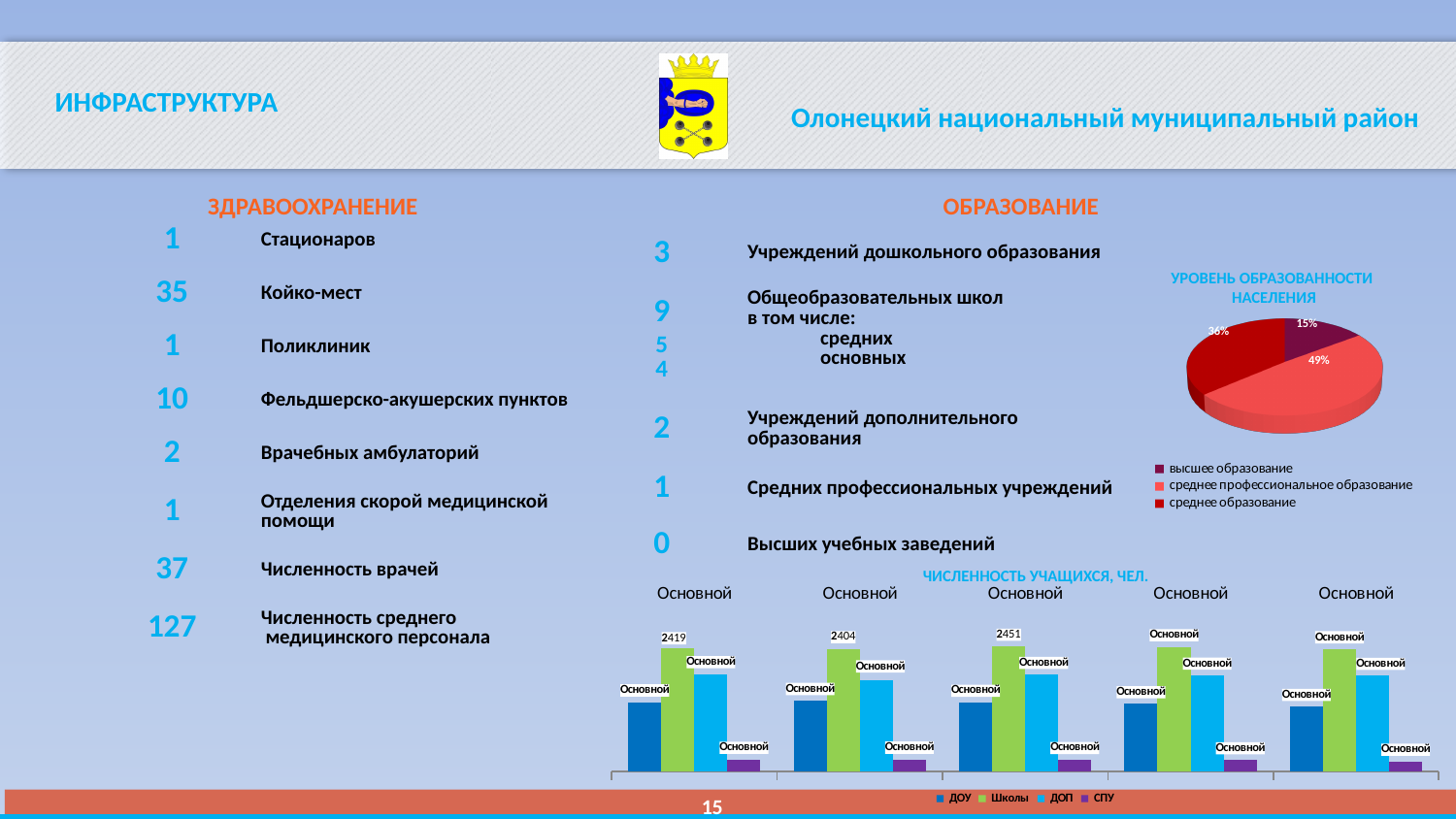
How many entries does the legend of the 'УРОВЕНЬ ОБРАЗОВАННОСТИ НАСЕЛЕНИЯ' pie chart list? 3 In the 'УРОВЕНЬ ОБРАЗОВАННОСТИ НАСЕЛЕНИЯ' pie chart, what share is labelled on the largest slice? 49% In the 'ЧИСЛЕННОСТЬ УЧАЩИХСЯ, ЧЕЛ.' bar chart, what is the data label on the Школы bar in the first (leftmost) group? 2419 In the 'ЧИСЛЕННОСТЬ УЧАЩИХСЯ, ЧЕЛ.' bar chart, which series has the shortest bar in every group? СПУ In the 'УРОВЕНЬ ОБРАЗОВАННОСТИ НАСЕЛЕНИЯ' pie chart, which legend entry is listed first? высшее образование In the 'УРОВЕНЬ ОБРАЗОВАННОСТИ НАСЕЛЕНИЯ' pie chart, what is the smallest percentage shown? 15% In the 'ЧИСЛЕННОСТЬ УЧАЩИХСЯ, ЧЕЛ.' bar chart, what is the data label on the Школы bar in the third group? 2451 How many groups of bars are shown in the 'ЧИСЛЕННОСТЬ УЧАЩИХСЯ, ЧЕЛ.' bar chart? 5 What kind of chart is the 'УРОВЕНЬ ОБРАЗОВАННОСТИ НАСЕЛЕНИЯ' chart? pie chart What kind of chart is the 'ЧИСЛЕННОСТЬ УЧАЩИХСЯ, ЧЕЛ.' chart? bar chart How many series does the legend of the 'ЧИСЛЕННОСТЬ УЧАЩИХСЯ, ЧЕЛ.' bar chart list? 4 In the 'ЧИСЛЕННОСТЬ УЧАЩИХСЯ, ЧЕЛ.' bar chart, what is the difference between the Школы values in the third group (2451) and the second group (2404)? 47